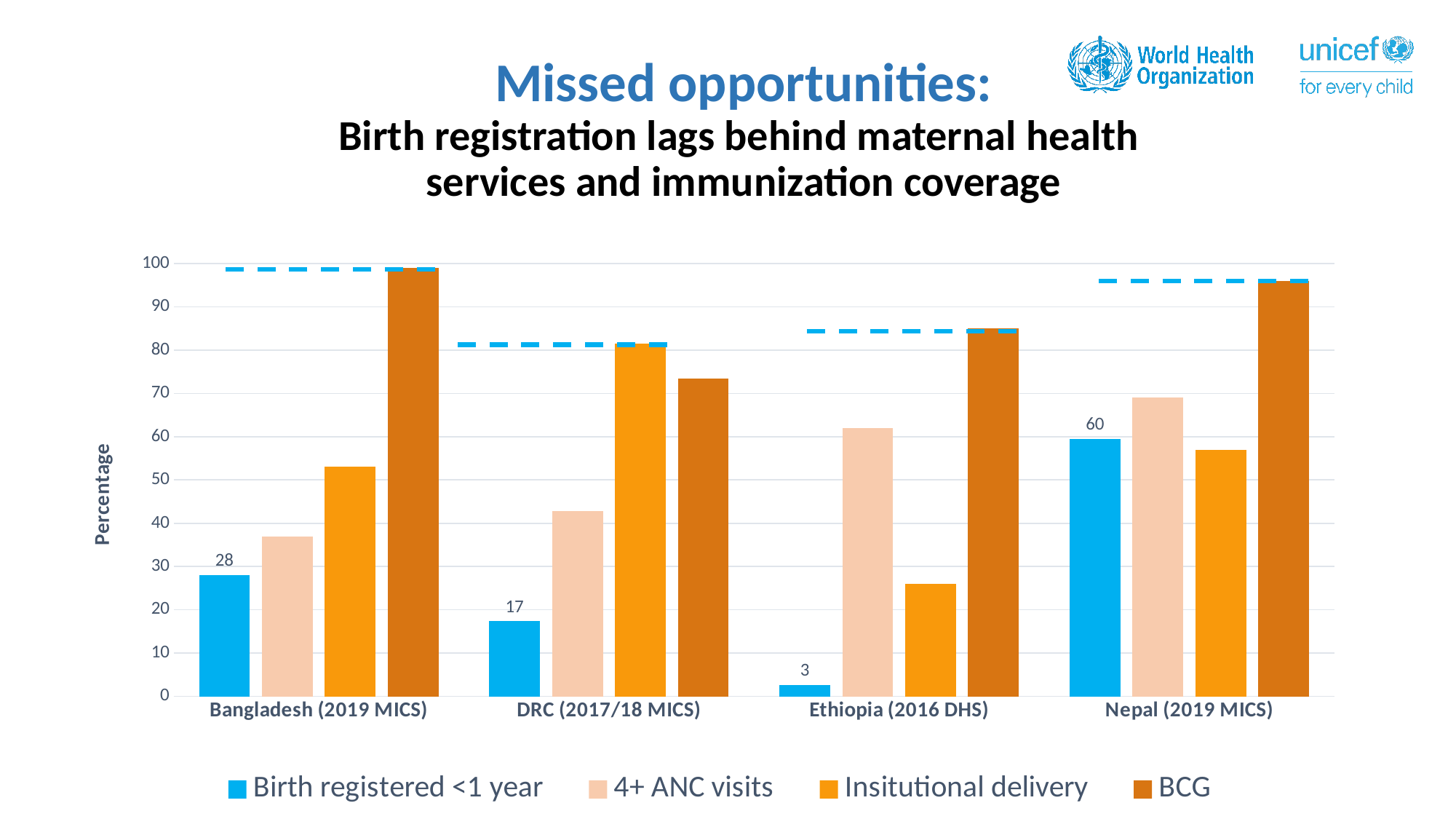
How many series does the legend list? 4 Which has a larger Birth registered <1 year value, Bangladesh (2019 MICS) or DRC (2017/18 MICS)? Bangladesh (2019 MICS) What kind of chart is shown on the slide? Bar chart Which country has the highest value for Birth registered <1 year? Nepal (2019 MICS) What is the value for Birth registered <1 year in Ethiopia (2016 DHS)? 3 Is the BCG value for Bangladesh (2019 MICS) greater or less than 90? greater How many countries are shown on the x axis of the chart? 4 Is the 4+ ANC visits value for DRC (2017/18 MICS) greater or less than 50? less Which country has the lowest value for Birth registered <1 year? Ethiopia (2016 DHS) What is the value for Birth registered <1 year in Bangladesh (2019 MICS)? 28 What is the difference between the Birth registered <1 year values for Nepal (2019 MICS) and Bangladesh (2019 MICS)? 32 What is the value for Birth registered <1 year in Nepal (2019 MICS)? 60